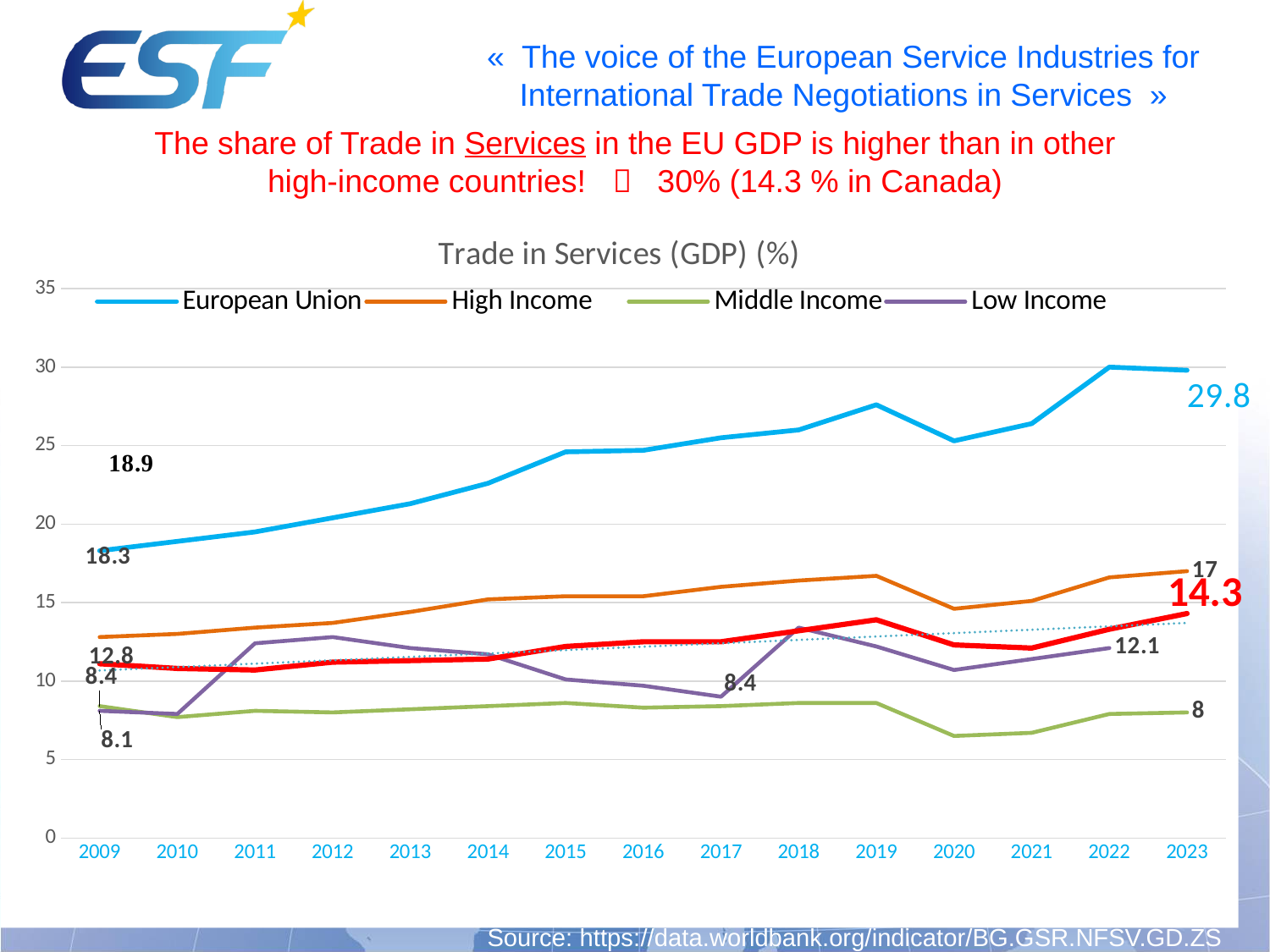
What is the value for High Income in 2023? 17 What type of chart is shown on the slide? line chart How many years are shown along the x axis of the chart? 15 What is the value for the European Union in 2023? 29.8 How many series does the chart legend list? 4 Is the value for the European Union in 2019 greater or less than 25? greater What is the value for Middle Income in 2023? 8 Which series has the lowest value in 2023? Middle Income What is the difference between the European Union and High Income values in 2023? 12.8 What is the title of the chart? Trade in Services (GDP) (%) Which series has the highest value in 2023? European Union